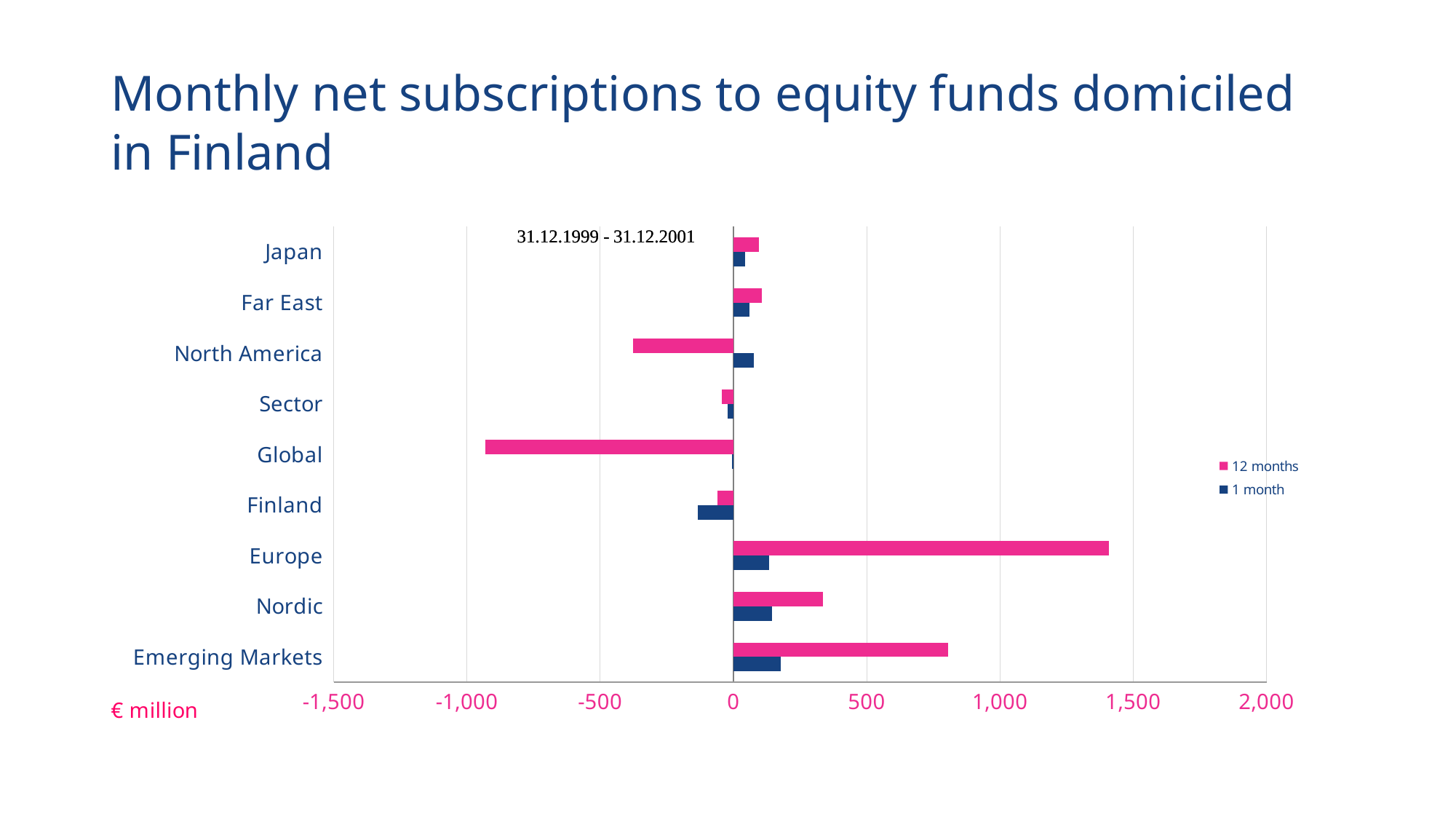
How many categories are shown on the chart? 9 Which category has the highest 12 months value? Europe Which category has the lowest 12 months value? Global Is the 12 months value for Europe greater or less than 1,000? greater Which is larger, the 12 months value for North America or the 12 months value for Far East? Far East What kind of chart is shown on the slide? bar chart How many series does the legend list? 2 Is the 12 months value for Emerging Markets greater or less than 500? greater What unit is shown for the x axis? € million What period is shown on the chart? 31.12.1999 - 31.12.2001 Is the 12 months value for Global greater or less than -500? less Which is larger, the 12 months value for Nordic or the 12 months value for Emerging Markets? Emerging Markets